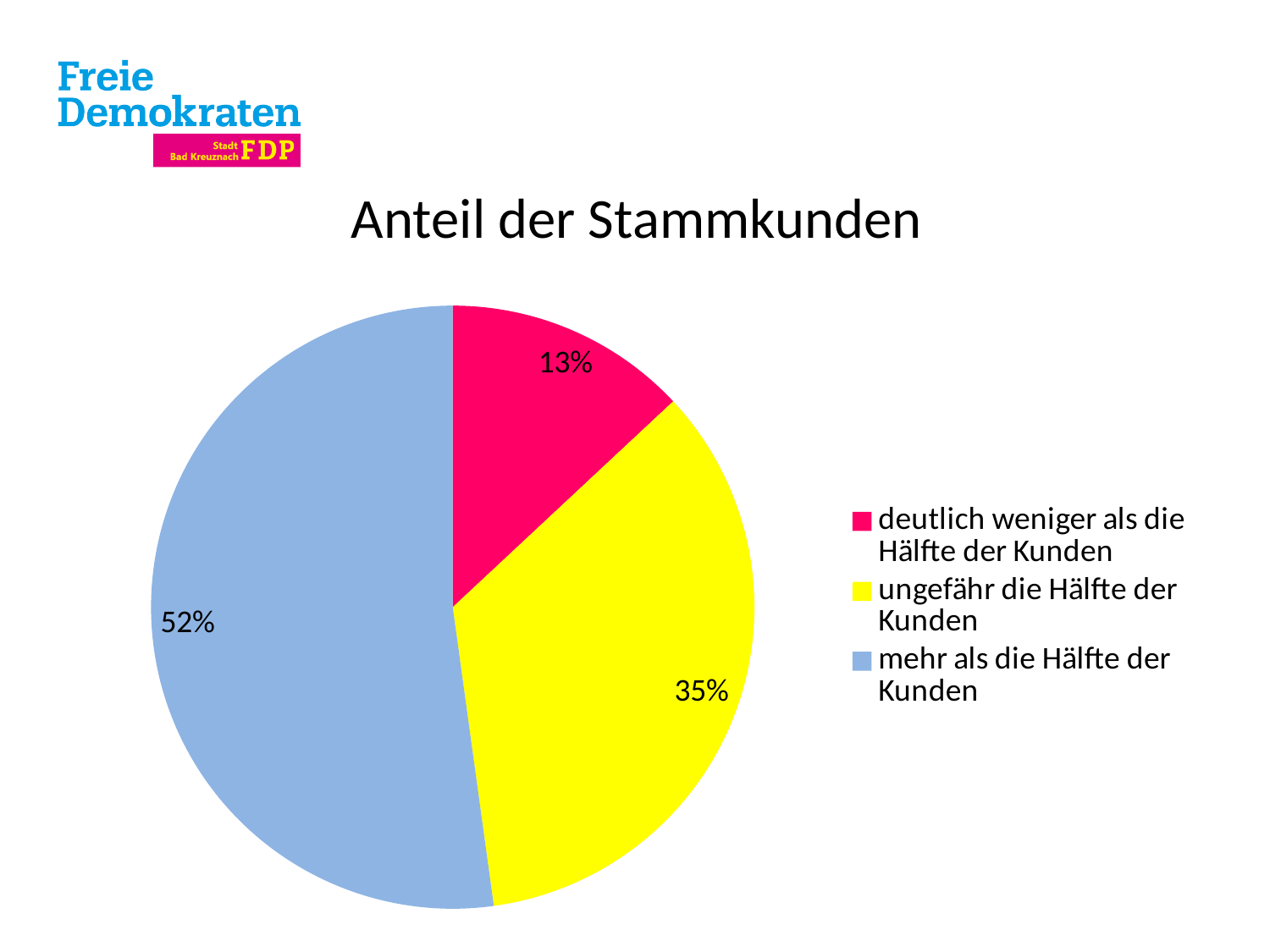
What share of the pie is labelled "deutlich weniger als die Hälfte der Kunden"? 13% What is the difference in percentage points between the "ungefähr die Hälfte der Kunden" slice and the "deutlich weniger als die Hälfte der Kunden" slice? 22 What is the title of the chart? Anteil der Stammkunden Which category has the largest slice of the pie? mehr als die Hälfte der Kunden What kind of chart is shown on the slide? pie chart How many slices does the pie chart have? 3 What is the difference in percentage points between the "mehr als die Hälfte der Kunden" slice and the "ungefähr die Hälfte der Kunden" slice? 17 Which slice is larger: "ungefähr die Hälfte der Kunden" or "deutlich weniger als die Hälfte der Kunden"? ungefähr die Hälfte der Kunden Which colour represents "ungefähr die Hälfte der Kunden" in the legend? yellow What share of the pie is labelled "ungefähr die Hälfte der Kunden"? 35% What share of the pie is labelled "mehr als die Hälfte der Kunden"? 52% Which category has the smallest slice of the pie? deutlich weniger als die Hälfte der Kunden